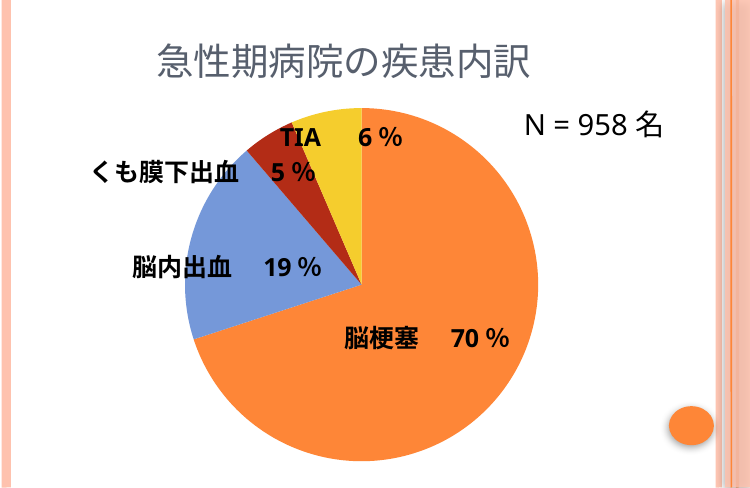
What kind of chart is shown on the slide? pie chart How many categories are shown in the pie chart? 4 Which is larger, the share for TIA or the share for くも膜下出血? TIA Which category has the smallest slice of the pie? くも膜下出血 What is the share for TIA? 6 % What is the total number of cases (N) stated on the slide? 958 名 What is the difference in percentage points between 脳梗塞 and 脳内出血? 51 What is the title of the chart? 急性期病院の疾患内訳 Which category has the largest slice of the pie? 脳梗塞 What is the share for くも膜下出血? 5 % What is the share for 脳梗塞? 70 % What is the share for 脳内出血? 19 %